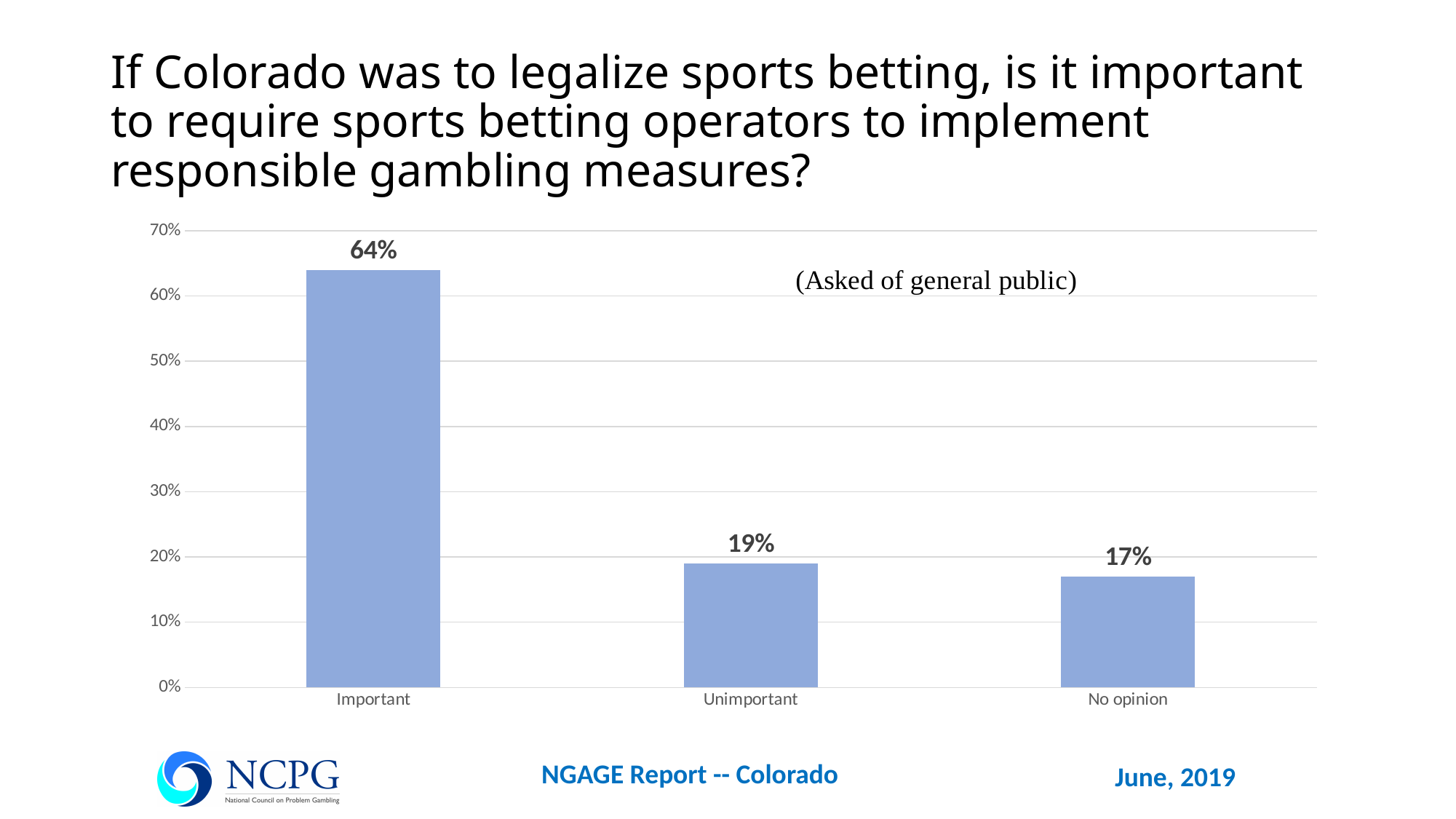
How many categories are shown on the x axis? 3 What is the difference in percentage points between Important and Unimportant? 45 Is the value for Important greater or less than 60%? greater What percentage of respondents said it is important to require sports betting operators to implement responsible gambling measures? 64% What is the value shown for the Unimportant category? 19% Which category has the highest value? Important What is the difference in percentage points between Unimportant and No opinion? 2 According to the note on the chart, who was this question asked of? General public What is the value shown for the No opinion category? 17% Which is larger, the value for Important or the value for No opinion? Important Which category has the lowest value? No opinion What kind of chart is shown on the slide? Bar chart